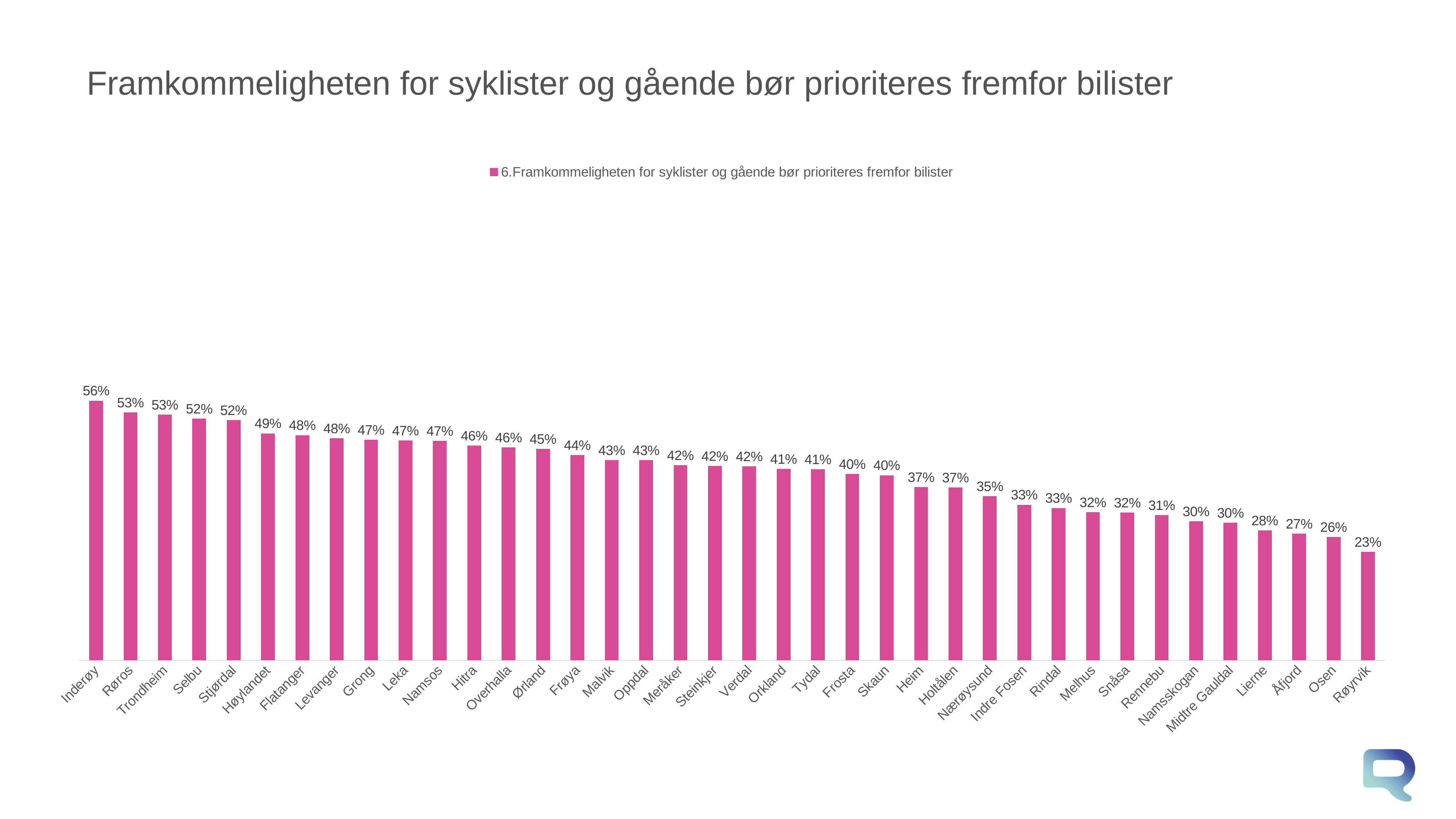
Which has a larger value, Osen or Stjørdal? Stjørdal What is the difference between the values for Levanger and Heim? 11% Which has a larger value, Frøya or Lierne? Frøya What is the value for Trondheim? 53% What kind of chart is shown on the slide? Bar chart What is the value for Midtre Gauldal? 30% What is the value for Steinkjer? 42% What is the difference between the values for Inderøy and Røyrvik? 33% Which municipality has the lowest value? Røyrvik Do the values rise or fall from left to right along the x axis? Fall Which municipality has the highest value? Inderøy How many municipalities are shown on the x axis? 38